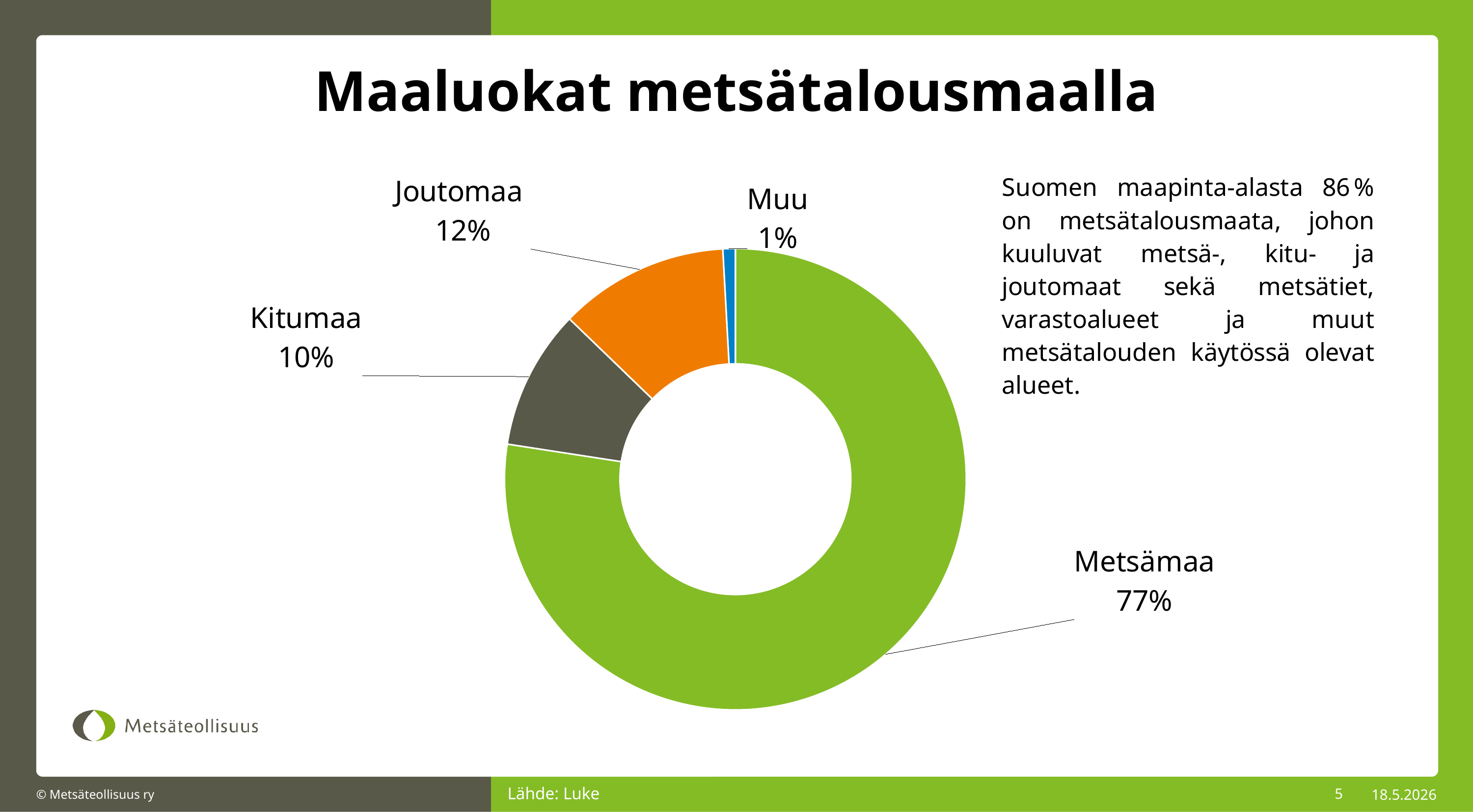
What kind of chart is shown on the slide? Doughnut (pie) chart What share of the chart does Metsämaa represent? 77% What share of the chart does Joutomaa represent? 12% What is the title of the slide? Maaluokat metsätalousmaalla How many categories are shown in the chart? 4 What is the difference in percentage points between Joutomaa and Kitumaa? 2 Which category has the smallest share of the chart? Muu What share of the chart does Muu represent? 1% What is the difference in percentage points between Metsämaa and Joutomaa? 65 Which category has the largest share of the chart? Metsämaa Which has a larger share, Joutomaa or Kitumaa? Joutomaa What share of the chart does Kitumaa represent? 10%